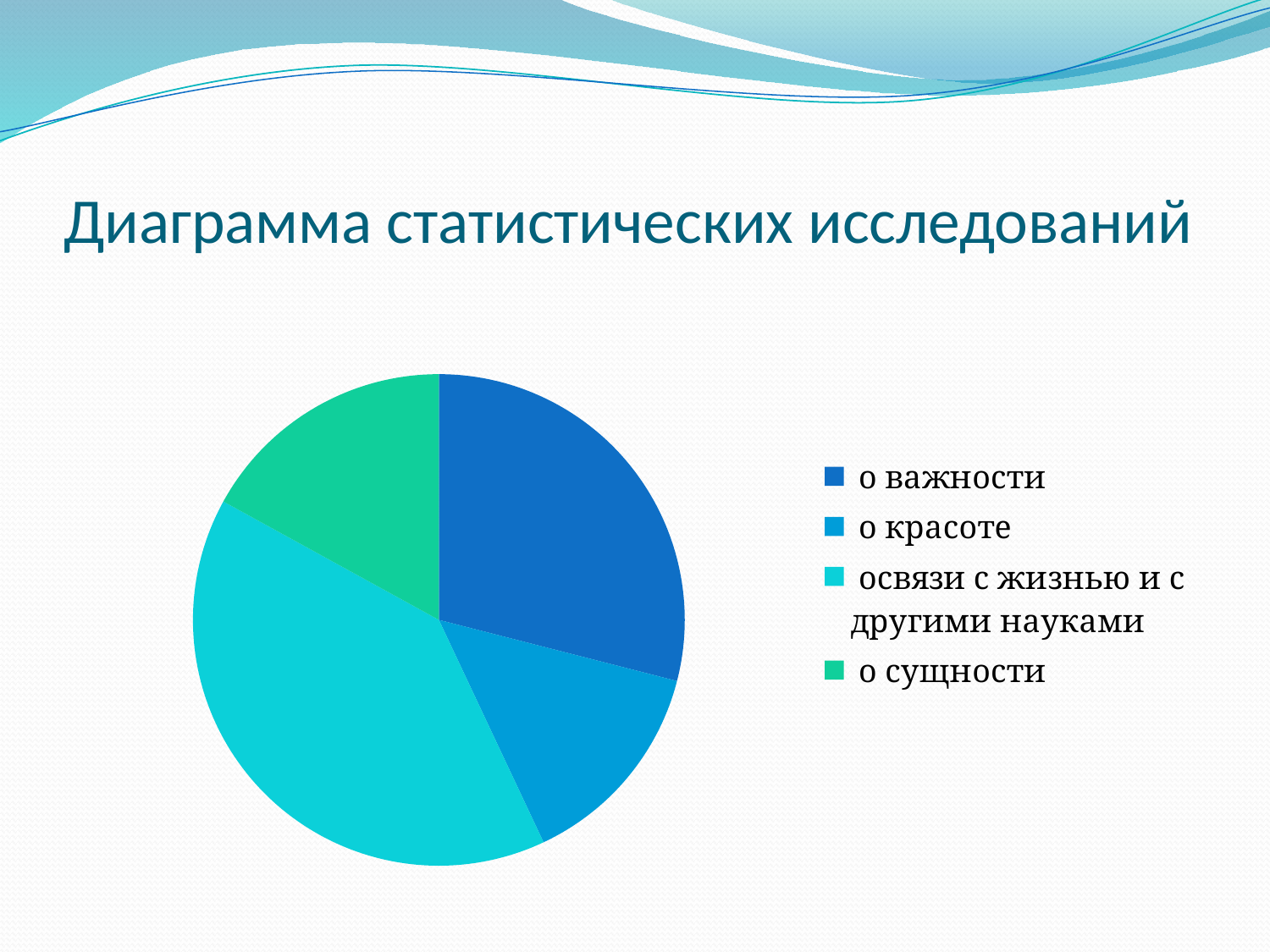
Which slice is larger, "освязи с жизнью и с другими науками" or "о важности"? освязи с жизнью и с другими науками How many slices does the pie chart have? 4 Which category has the largest slice of the pie chart? освязи с жизнью и с другими науками What kind of chart is shown on the slide? pie chart Which slice is larger, "о важности" or "о красоте"? о важности What is the title of the slide containing the pie chart? Диаграмма статистических исследований Which slice is larger, "освязи с жизнью и с другими науками" or "о сущности"? освязи с жизнью и с другими науками How many entries does the legend of the pie chart list? 4 What colour is the "о сущности" slice in the pie chart? green